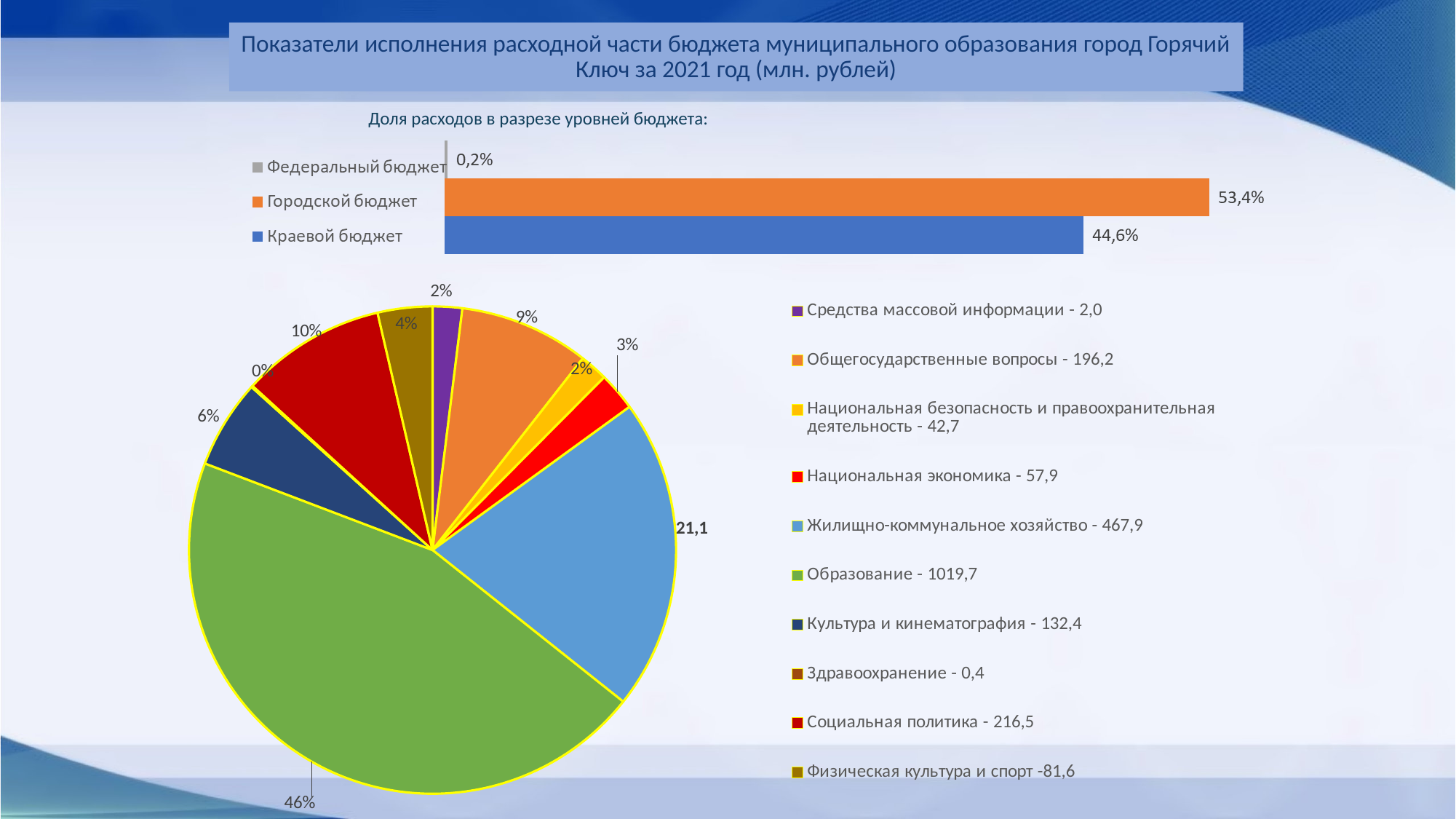
In the bar chart 'Доля расходов в разрезе уровней бюджета', how many budget levels are shown? 3 In the pie chart at the bottom of the slide, which category has the largest slice? Образование In the pie chart at the bottom of the slide, what percentage label is shown on the Образование slice? 46% In the bar chart 'Доля расходов в разрезе уровней бюджета', what is the value for Городской бюджет? 53,4% In the bar chart 'Доля расходов в разрезе уровней бюджета', which budget level has the lowest share? Федеральный бюджет In the bar chart 'Доля расходов в разрезе уровней бюджета', what is the value for Федеральный бюджет? 0,2% In the bar chart 'Доля расходов в разрезе уровней бюджета', what is the value for Краевой бюджет? 44,6% In the pie chart at the bottom of the slide, what is the value for Образование according to the legend? 1019,7 In the pie chart at the bottom of the slide, how many categories does the legend list? 10 In the bar chart 'Доля расходов в разрезе уровней бюджета', what is the difference between Городской бюджет and Краевой бюджет? 8,8% In the bar chart 'Доля расходов в разрезе уровней бюджета', which budget level has the highest share? Городской бюджет What type of chart is the chart at the top of the slide titled 'Доля расходов в разрезе уровней бюджета'? bar chart